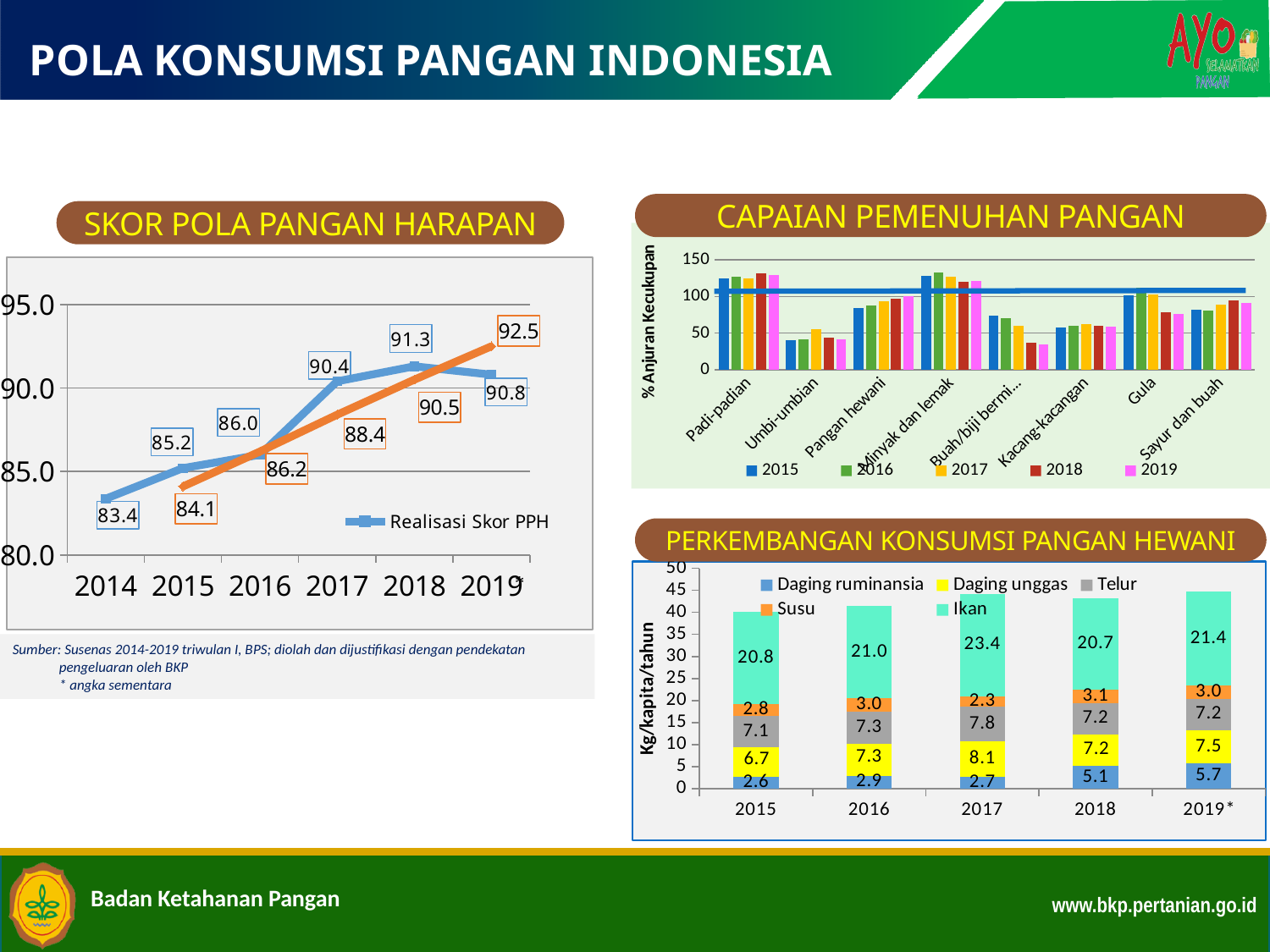
In the PERKEMBANGAN KONSUMSI PANGAN HEWANI chart, what is the Ikan value for 2017? 23.4 In the SKOR POLA PANGAN HARAPAN chart, how many years are shown on the x axis? 6 In the CAPAIAN PEMENUHAN PANGAN chart, what kind of chart is shown? Bar chart In the SKOR POLA PANGAN HARAPAN chart, what is the difference between the Realisasi Skor PPH in 2017 and in 2016? 4.4 In the CAPAIAN PEMENUHAN PANGAN chart, is the value for Padi-padian in 2015 greater or less than 100? greater In the PERKEMBANGAN KONSUMSI PANGAN HEWANI chart, which is larger, Daging ruminansia in 2018 or in 2017? 2018 In the SKOR POLA PANGAN HARAPAN chart, which year has the highest Realisasi Skor PPH? 2018 In the SKOR POLA PANGAN HARAPAN chart, what is the Realisasi Skor PPH value for 2018? 91.3 In the CAPAIAN PEMENUHAN PANGAN chart, how many series does the legend list? 5 In the SKOR POLA PANGAN HARAPAN chart, what is the Realisasi Skor PPH value for 2014? 83.4 In the PERKEMBANGAN KONSUMSI PANGAN HEWANI chart, what is the total of the stacked bar for 2015? 40.0 In the CAPAIAN PEMENUHAN PANGAN chart, is the value for Umbi-umbian in 2015 greater or less than 50? less